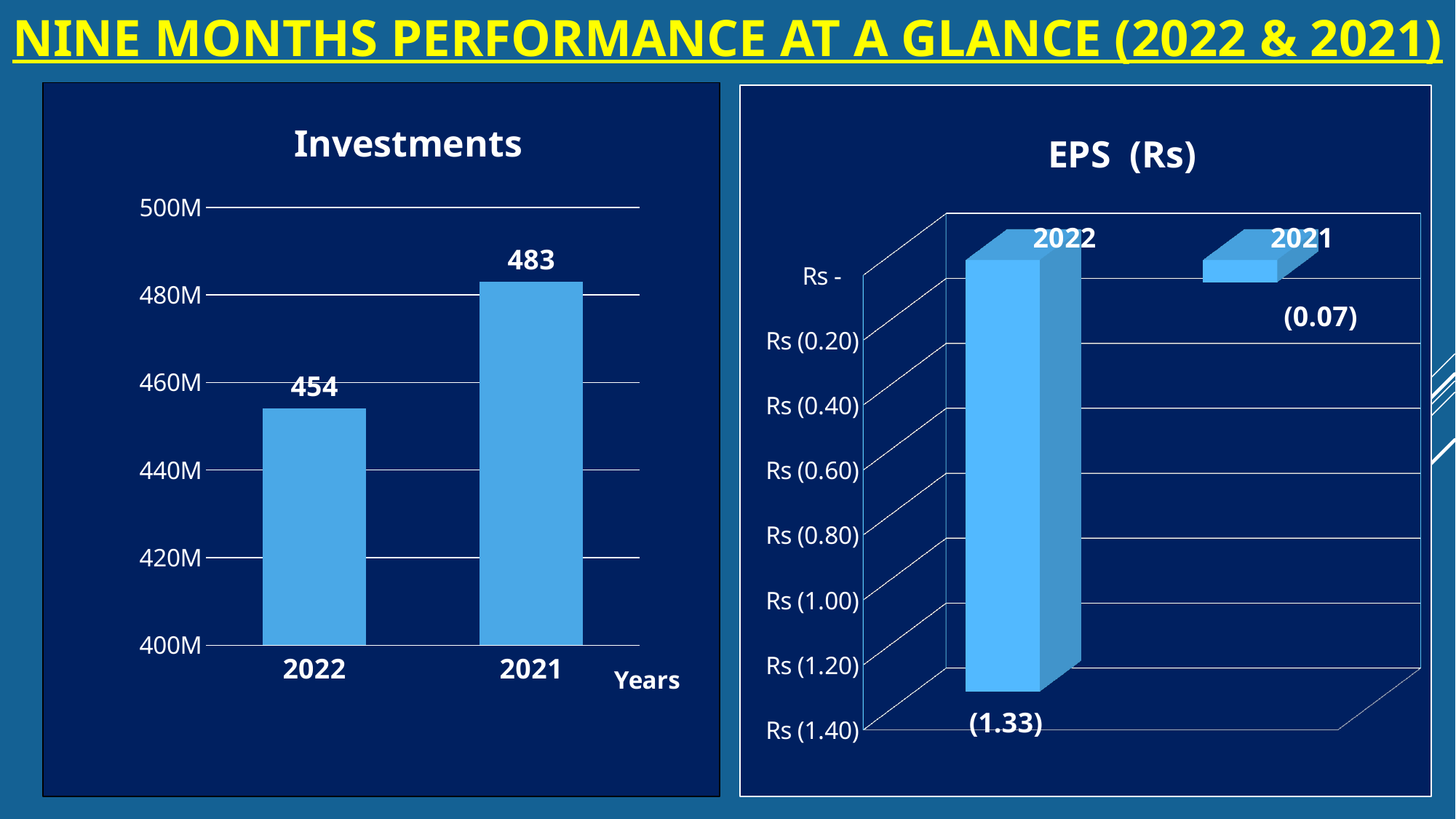
In the Investments chart, is the value for 2022 greater or less than 460M? less In the EPS (Rs) chart, what is the value for 2022? (1.33) In the Investments chart, what is the difference between the 2021 and 2022 values? 29 What kind of chart is the Investments chart? bar chart In the Investments chart, what is the value for 2022? 454 In the EPS (Rs) chart, is the value for 2022 greater or less than Rs (1.00)? less In the EPS (Rs) chart, what is the value for 2021? (0.07) What is the label on the x axis of the Investments chart? Years In the Investments chart, how many years are plotted? 2 In the EPS (Rs) chart, which year has the lower EPS? 2022 In the Investments chart, what is the value for 2021? 483 In the Investments chart, which year has the higher value? 2021